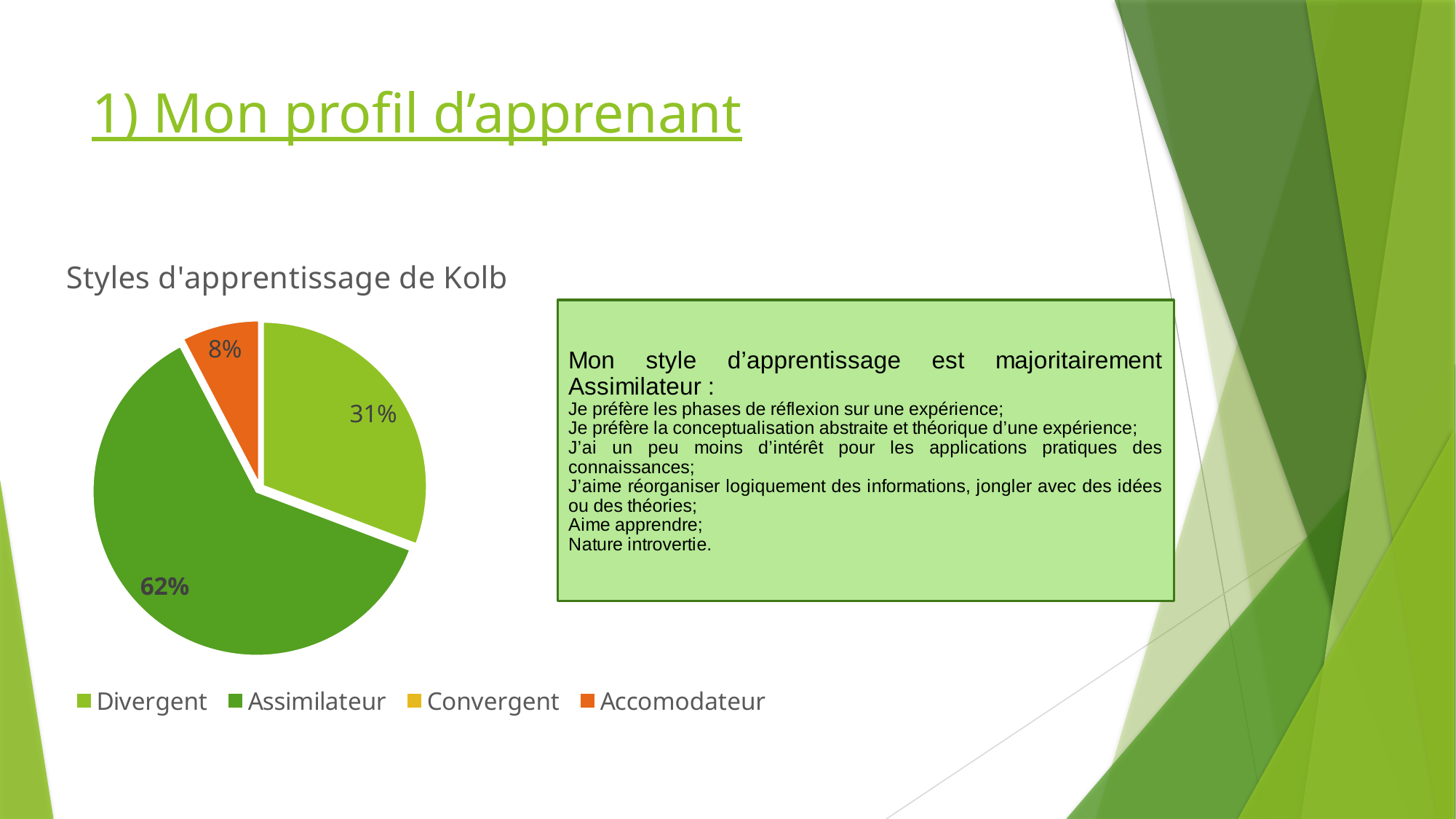
What percentage of the pie does the Divergent slice represent? 31% Which labelled slice of the pie is the smallest? Accomodateur What type of chart is shown on the slide? pie chart What colour is the Accomodateur slice in the pie chart? orange What percentage of the pie does the Accomodateur slice represent? 8% What is the difference in percentage points between the Assimilateur and Divergent slices? 31 Which learning style has the largest share of the pie? Assimilateur What is the title of the chart? Styles d'apprentissage de Kolb What is the difference in percentage points between the Divergent and Accomodateur slices? 23 How many entries does the chart legend list? 4 Which is larger, the Divergent slice or the Accomodateur slice? Divergent What percentage of the pie does the Assimilateur slice represent? 62%